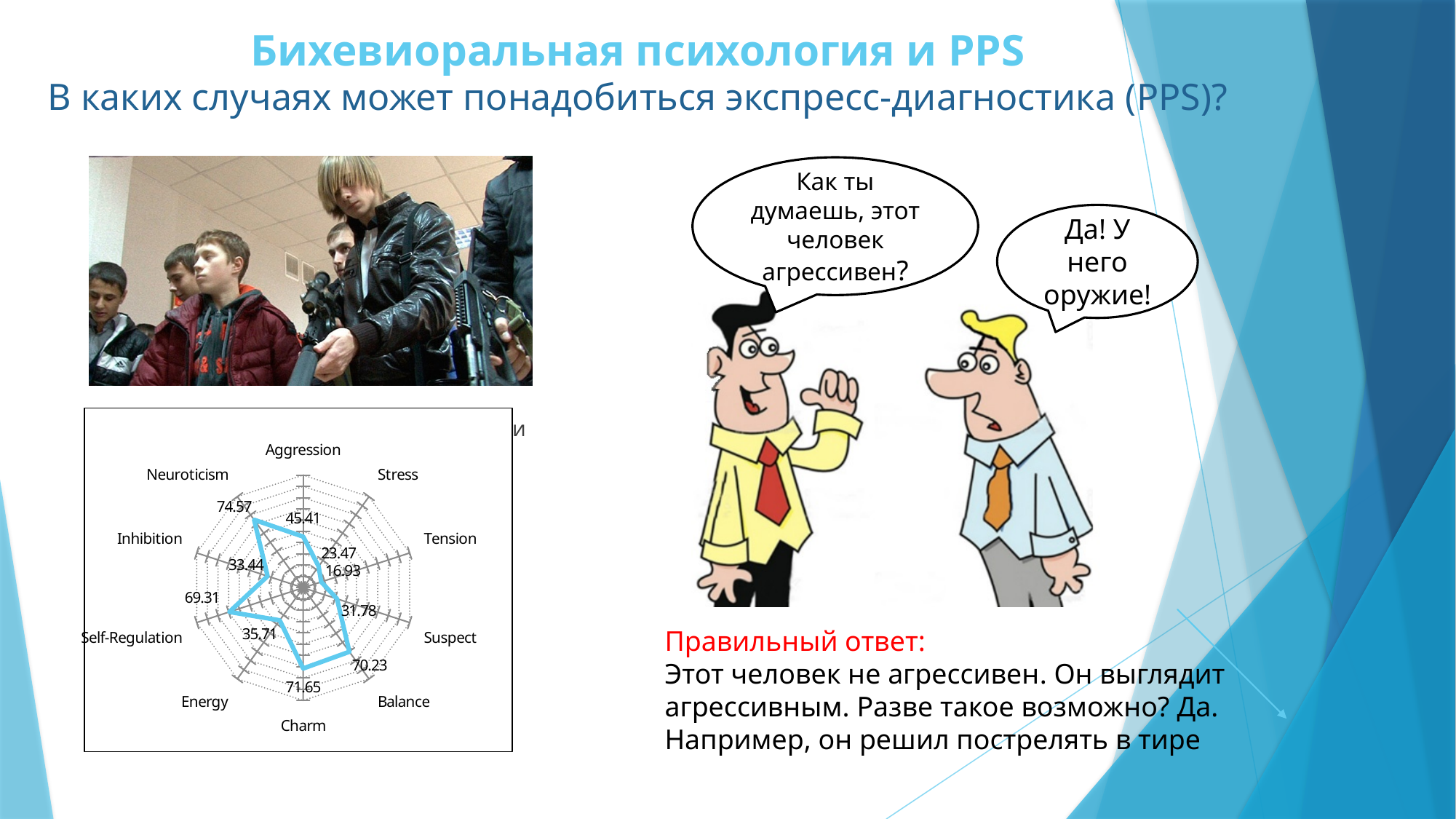
Which category has the highest value in the radar chart? Neuroticism What is the value for Tension in the radar chart? 16.93 What is the difference between the values for Charm and Balance in the radar chart? 1.42 What is the value for Neuroticism in the radar chart? 74.57 What is the difference between the values for Aggression and Stress in the radar chart? 21.94 Which category has the lowest value in the radar chart? Tension What is the value for Self-Regulation in the radar chart? 69.31 What is the value for Aggression in the radar chart? 45.41 Which is larger in the radar chart, the value for Energy or the value for Inhibition? Energy What type of chart is shown on the slide? radar chart What is the value for Charm in the radar chart? 71.65 How many categories (axes) does the radar chart have? 10